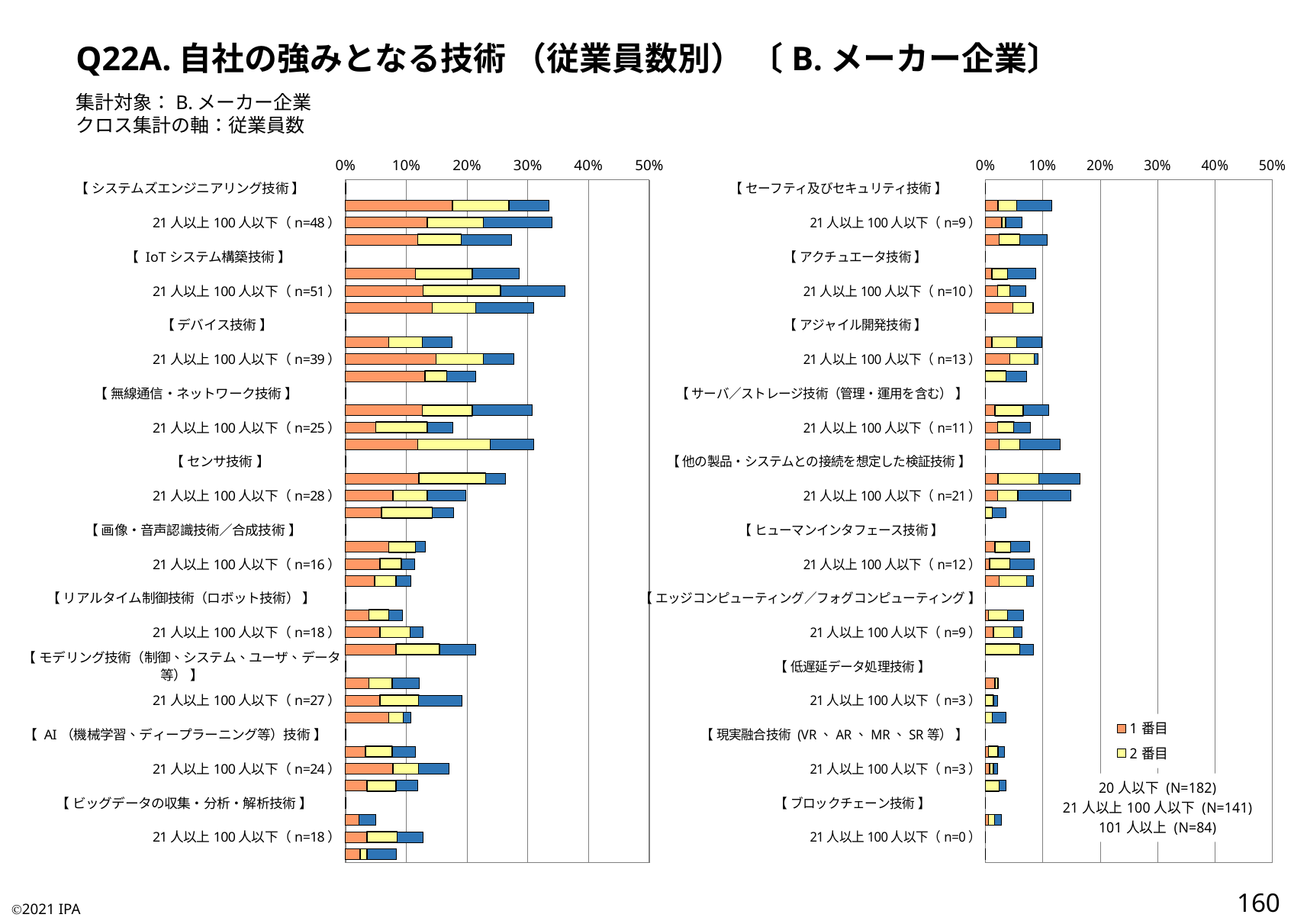
How many technology categories are shown in the right chart? 10 In the right chart, is the total bar for 20人以下 under 【低遅延データ処理技術】 greater or less than 10%? less In the left chart, is the total bar for 20人以下 under 【ビッグデータの収集・分析・解析技術】 greater or less than 10%? less In the right chart, is the total bar for 20人以下 under 【他の製品・システムとの接続を想定した検証技術】 greater or less than 10%? greater What type of chart is used on this slide? bar chart How many series does the legend list? 2 What are the two legend entries shown on the slide? 1番目, 2番目 What is the maximum value shown on the x axis of the charts? 50% In the left chart, which is larger: the 20人以下 bar for 【システムズエンジニアリング技術】 or the 20人以下 bar for 【ビッグデータの収集・分析・解析技術】? 【システムズエンジニアリング技術】 How many technology categories are shown in the left chart? 10